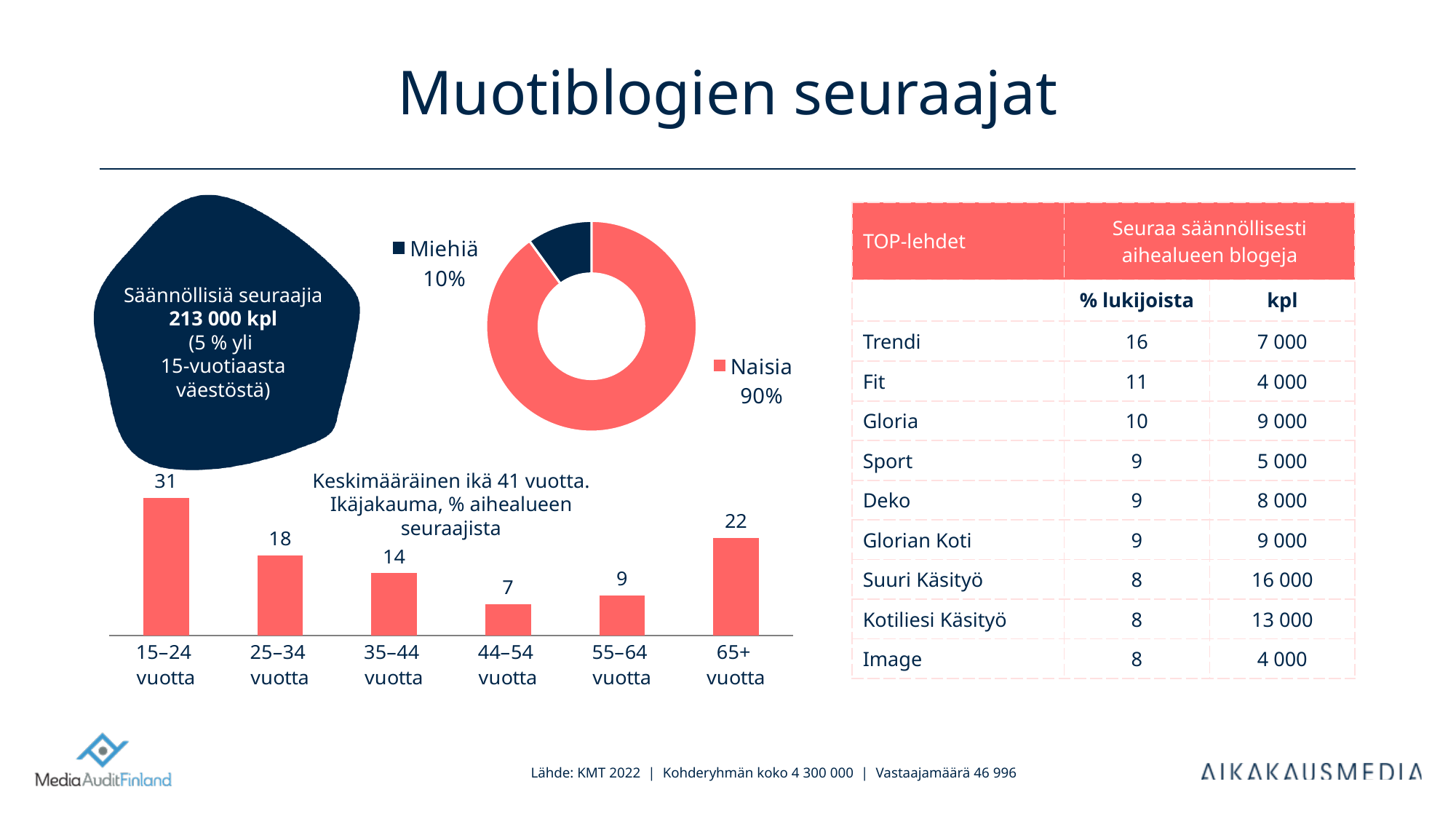
In the age distribution bar chart, which is larger: the value for 55–64 vuotta or 44–54 vuotta? 55–64 vuotta In the age distribution bar chart, what is the difference between the values for 15–24 vuotta and 25–34 vuotta? 13 In the age distribution bar chart, what is the value for 15–24 vuotta? 31 In the donut chart, what share is shown for Miehiä? 10% In the age distribution bar chart, which age group has the lowest value? 44–54 vuotta What kind of chart is the age distribution chart? Bar chart In the age distribution bar chart, which age group has the highest value? 15–24 vuotta How many age groups are shown in the age distribution bar chart? 6 What kind of chart is the gender chart (Miehiä / Naisia)? Donut chart In the age distribution bar chart, what is the value for 65+ vuotta? 22 In the donut chart, what share is shown for Naisia? 90% How many series does the legend of the donut chart list? 2